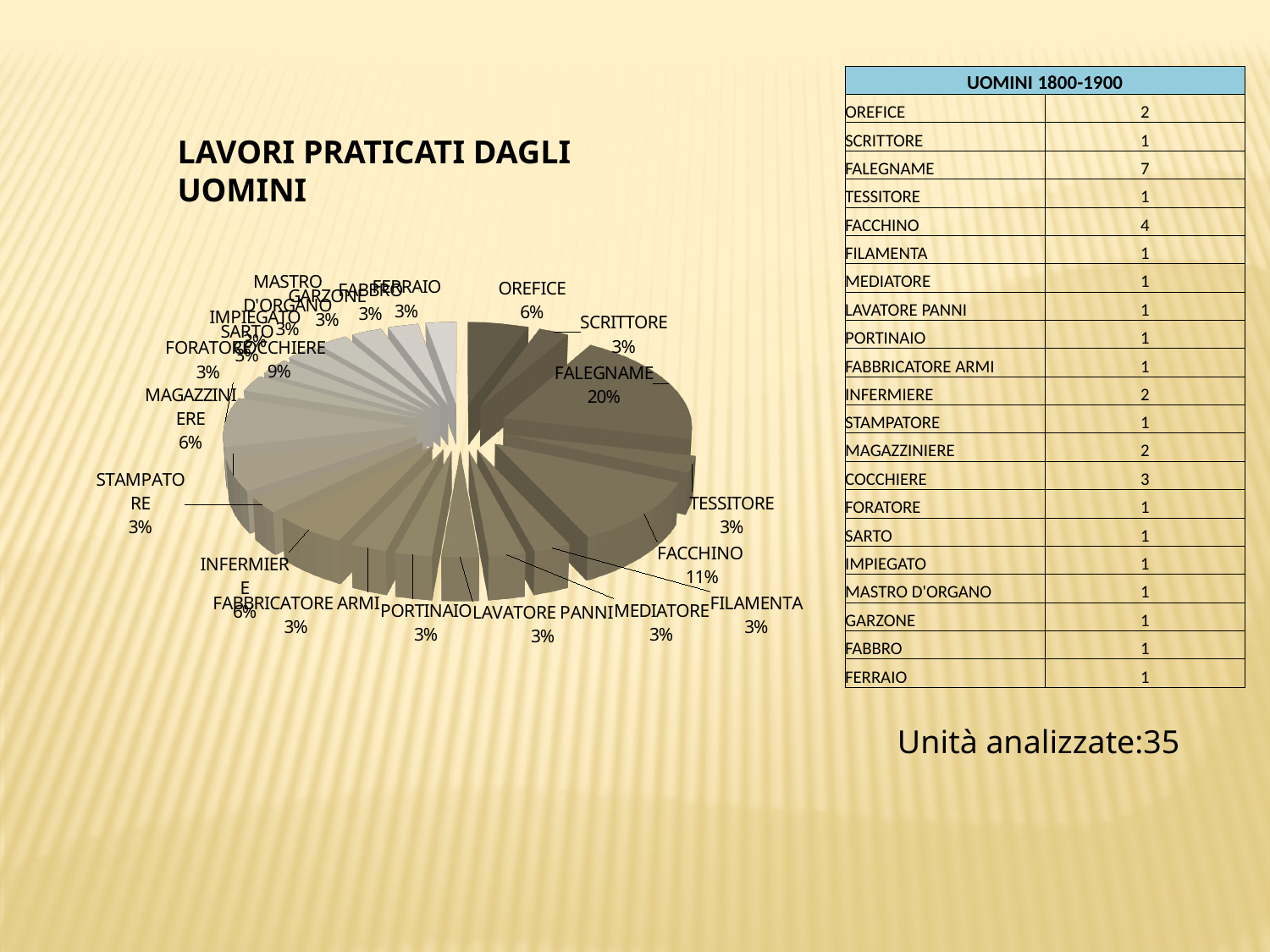
What share of the pie does COCCHIERE represent? 9% Which category has the largest slice of the pie? FALEGNAME Which is larger, the slice for FACCHINO or the slice for COCCHIERE? FACCHINO What is the title of the chart? LAVORI PRATICATI DAGLI UOMINI What type of chart is shown on the slide? pie chart What percentage is shown for SCRITTORE? 3% What is the difference in percentage points between FALEGNAME and OREFICE? 14 What share of the pie does FACCHINO represent? 11% What percentage is shown for MAGAZZINIERE? 6% What is the difference in percentage points between FALEGNAME and FACCHINO? 9 What share of the pie does FALEGNAME represent? 20% What percentage is shown for OREFICE? 6%